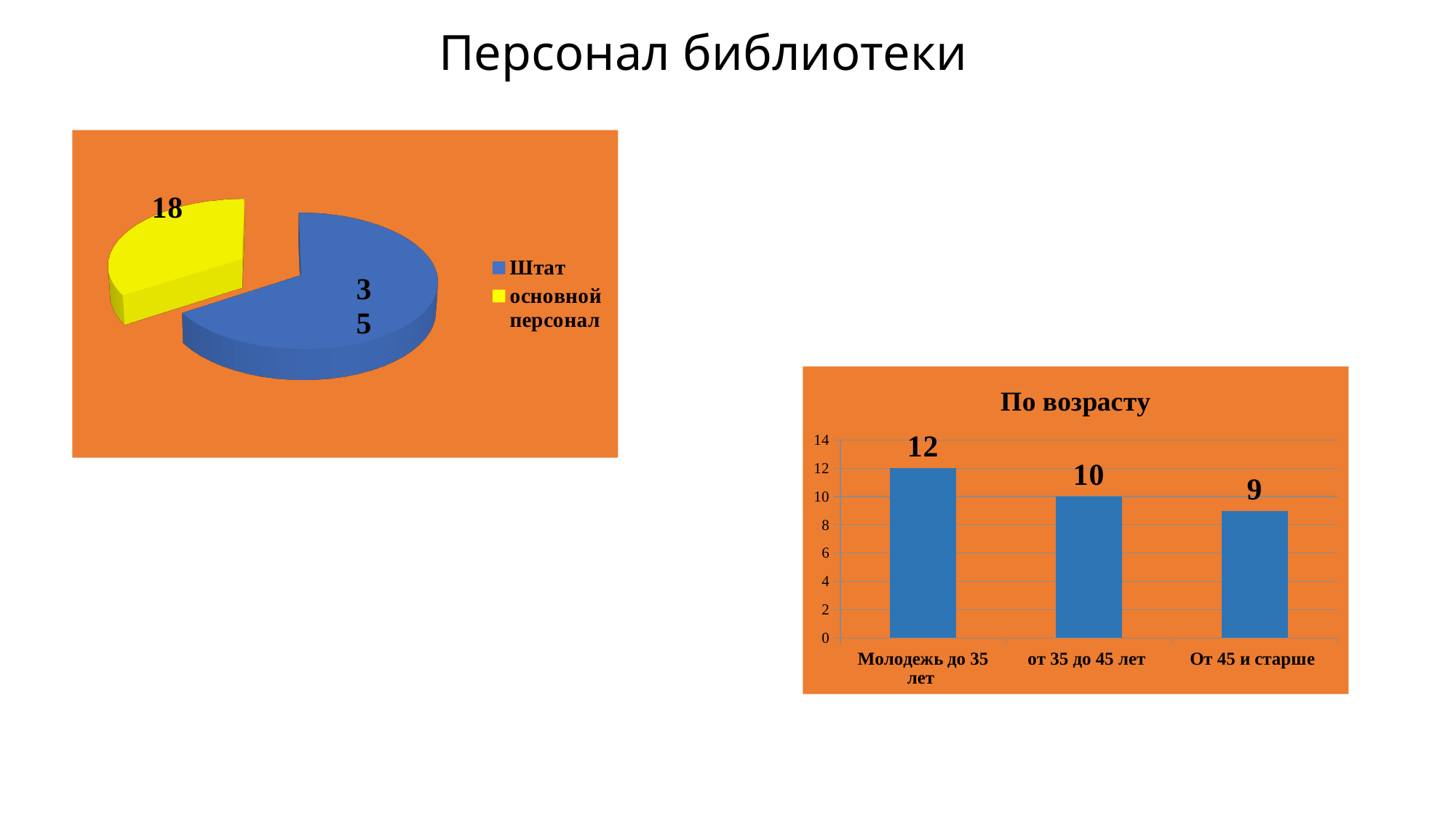
In the bar chart titled 'По возрасту', do the values rise or fall from left to right along the x axis? fall In the pie chart on the left of the slide, how many entries does the legend list? 2 In the pie chart on the left of the slide, which slice is larger, 'Штат' or 'основной персонал'? Штат What kind of chart is the chart titled 'По возрасту' on the right of the slide? bar chart In the bar chart titled 'По возрасту', which category has the lowest value? От 45 и старше In the bar chart titled 'По возрасту', what is the value for 'от 35 до 45 лет'? 10 In the bar chart titled 'По возрасту', what is the difference between the values for 'Молодежь до 35 лет' and 'От 45 и старше'? 3 In the pie chart on the left of the slide, what is the value for 'основной персонал'? 18 In the bar chart titled 'По возрасту', what is the value for 'От 45 и старше'? 9 In the bar chart titled 'По возрасту', which category has the highest value? Молодежь до 35 лет In the bar chart titled 'По возрасту', how many categories are shown on the x axis? 3 In the bar chart titled 'По возрасту', what is the value for 'Молодежь до 35 лет'? 12